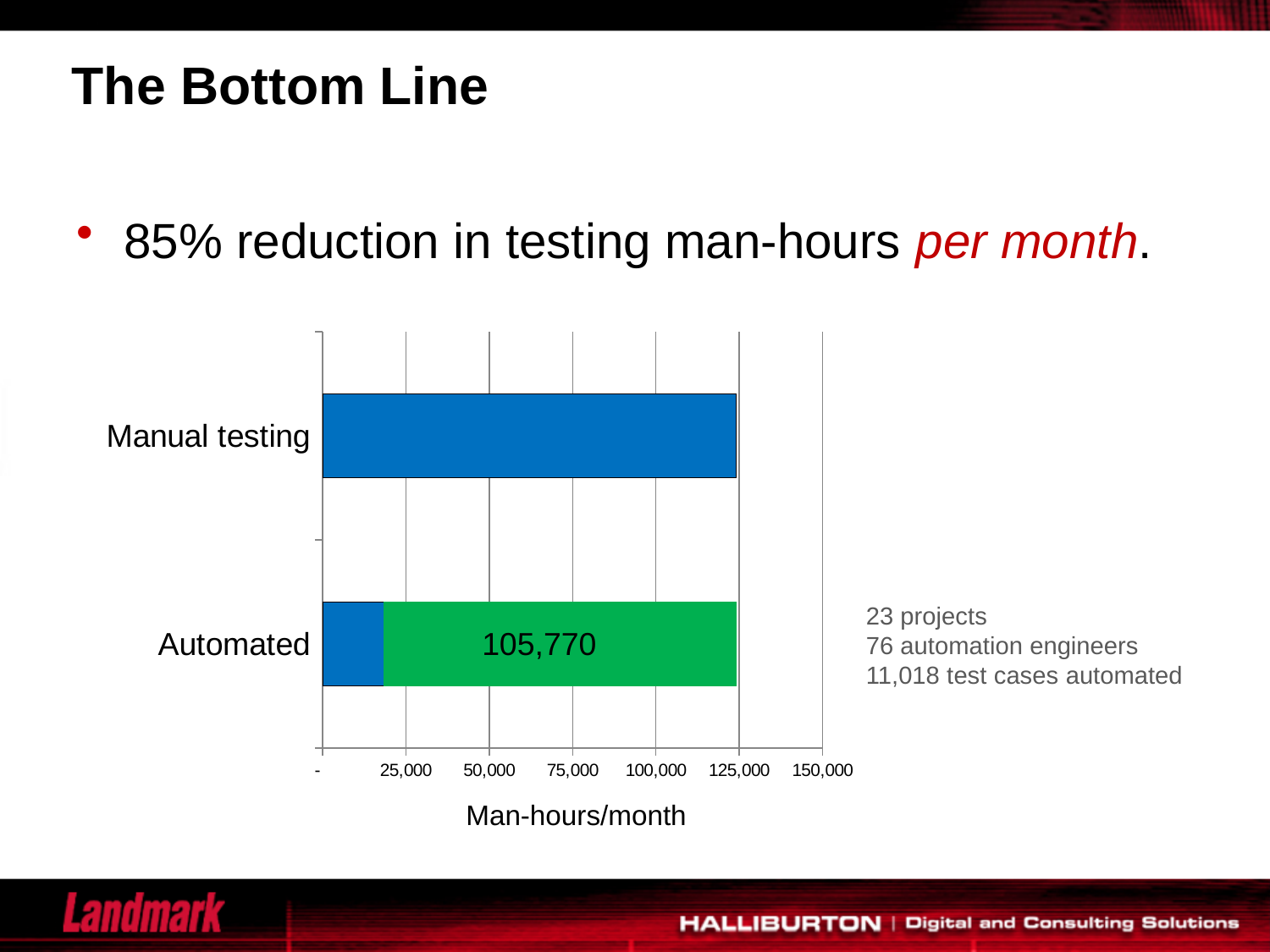
Is the Manual testing bar greater or less than 75,000? greater Which is larger: the Manual testing bar or the blue segment of the Automated bar? Manual testing What is the title of the chart's horizontal axis? Man-hours/month Which category's bar carries a printed data label? Automated What kind of chart is shown on the slide? bar chart What is the highest tick value shown on the horizontal axis? 150,000 Is the value for Manual testing greater or less than 100,000? greater How many categories are shown on the chart's vertical axis? 2 What value is printed on the green segment of the Automated bar? 105,770 Is the blue segment of the Automated bar greater or less than 25,000? less